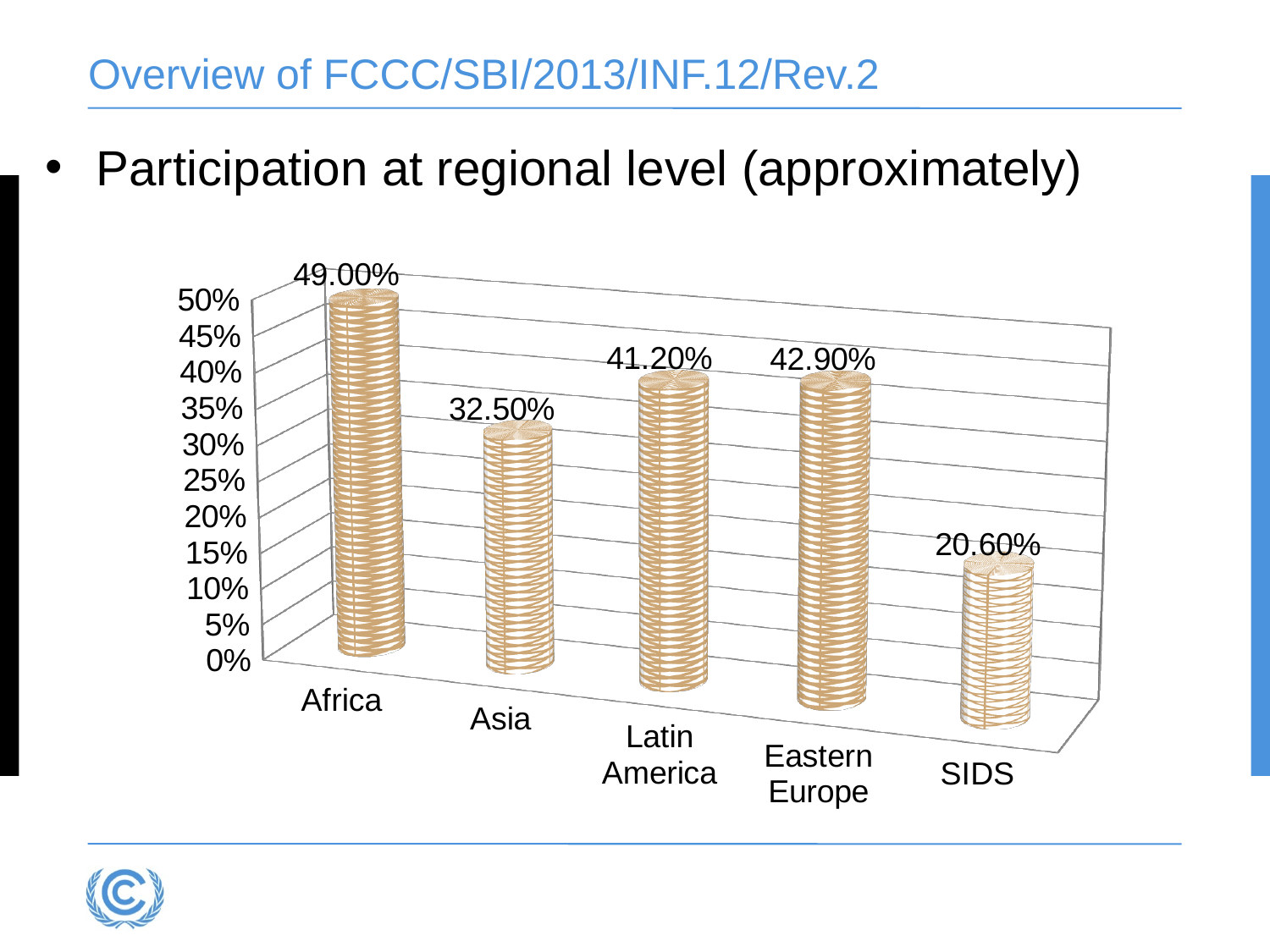
What is the value for Latin America? 41.20% What is the value for SIDS? 20.60% What is the value for Africa? 49.00% Which region has the lowest value? SIDS What is the value for Eastern Europe? 42.90% What is the difference between the values for Africa and SIDS? 28.40% Which region has the highest value? Africa What kind of chart is shown on the slide? Bar chart What is the difference between the values for Eastern Europe and Latin America? 1.70% Which is larger, the value for Asia or the value for Latin America? Latin America How many regions are shown in the chart? 5 What is the value for Asia? 32.50%